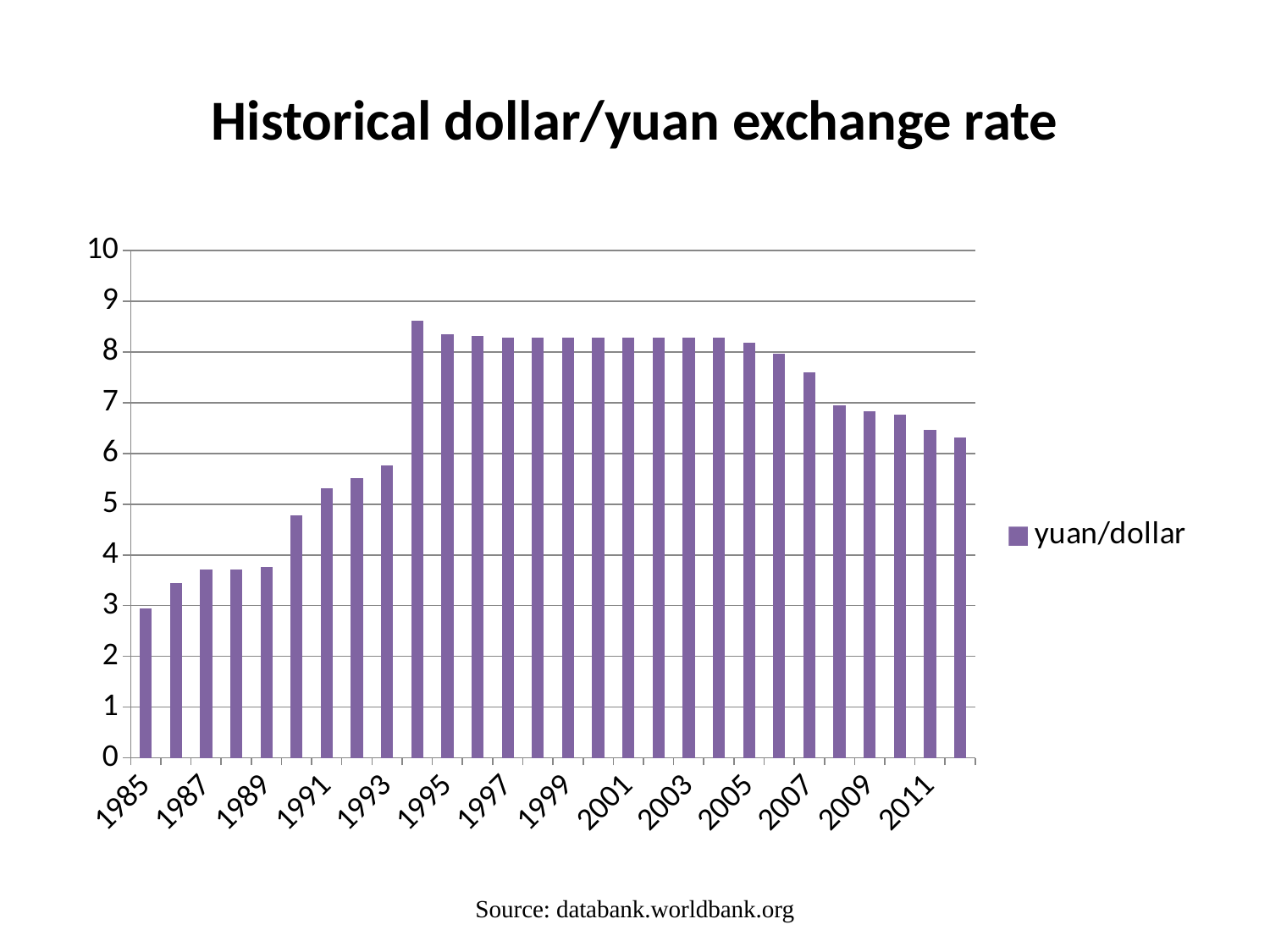
Is the value for 2007 greater or less than 7? greater What kind of chart is shown on the slide? bar chart Which year has the highest yuan/dollar value? 1994 How many series does the legend list? 1 Is the value for 1994 greater or less than 8? greater What is the name of the series shown in the legend? yuan/dollar Is the value for 2011 greater or less than 7? less Which year has the lowest yuan/dollar value? 1985 Which is larger, the value for 1993 or the value for 1995? 1995 What is the title of the chart? Historical dollar/yuan exchange rate Do the values rise or fall from 2005 to 2011? fall